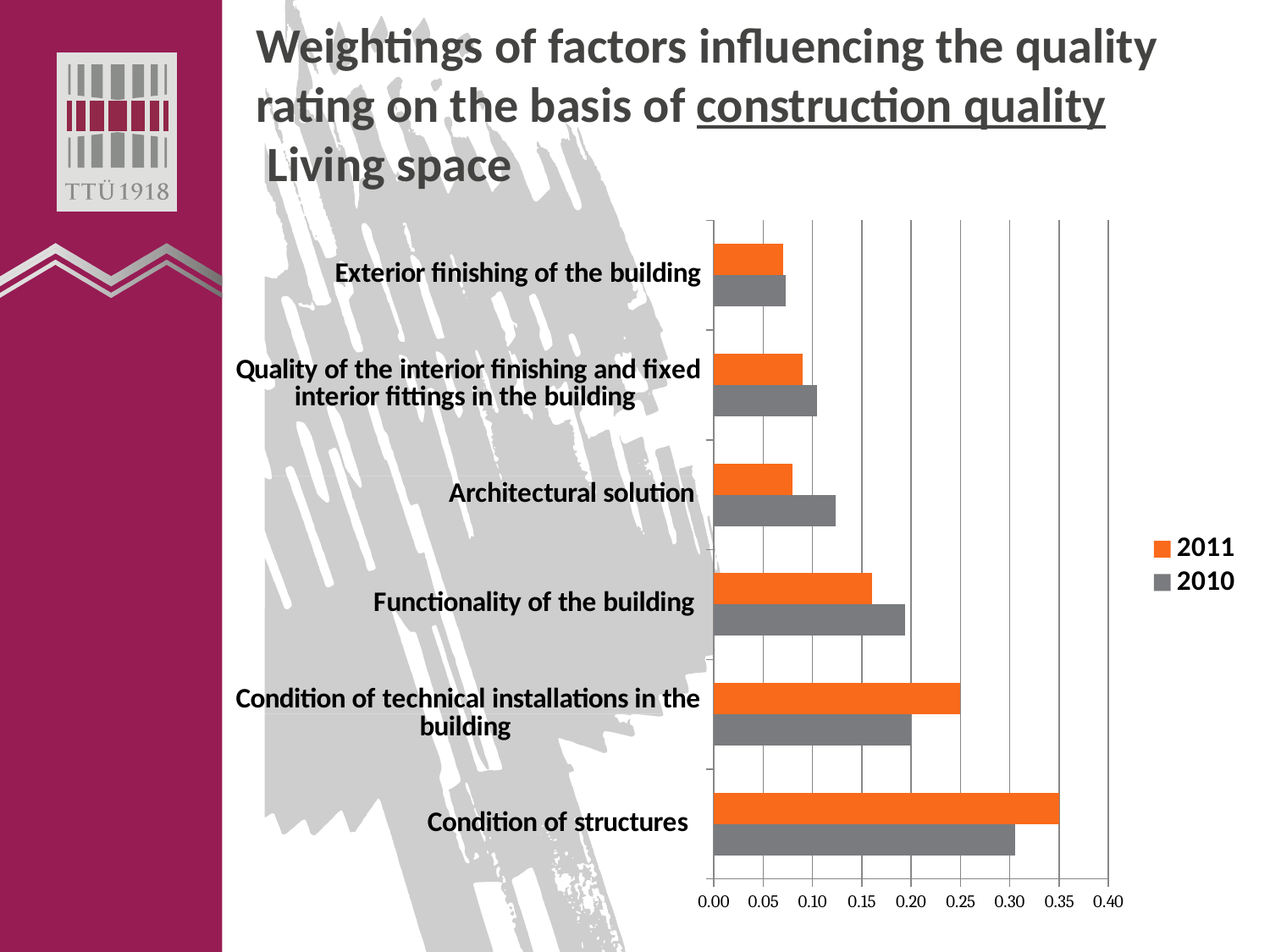
Is the 2010 value for Condition of structures greater or less than 0.25? greater How many series does the legend list? 2 Is the 2011 value for Functionality of the building greater or less than 0.20? less Is the 2010 value for Architectural solution greater or less than 0.10? greater Which factor has the highest weighting for 2010? Condition of structures Which factor has the lowest weighting for 2010? Exterior finishing of the building Which colour represents the 2011 series in the legend? orange For Condition of technical installations in the building, which year has the larger weighting, 2010 or 2011? 2011 Which factor has the highest weighting for 2011? Condition of structures For Functionality of the building, which year has the larger weighting, 2010 or 2011? 2010 What kind of chart is shown on the slide? bar chart How many categories (factors) are plotted on the chart? 6